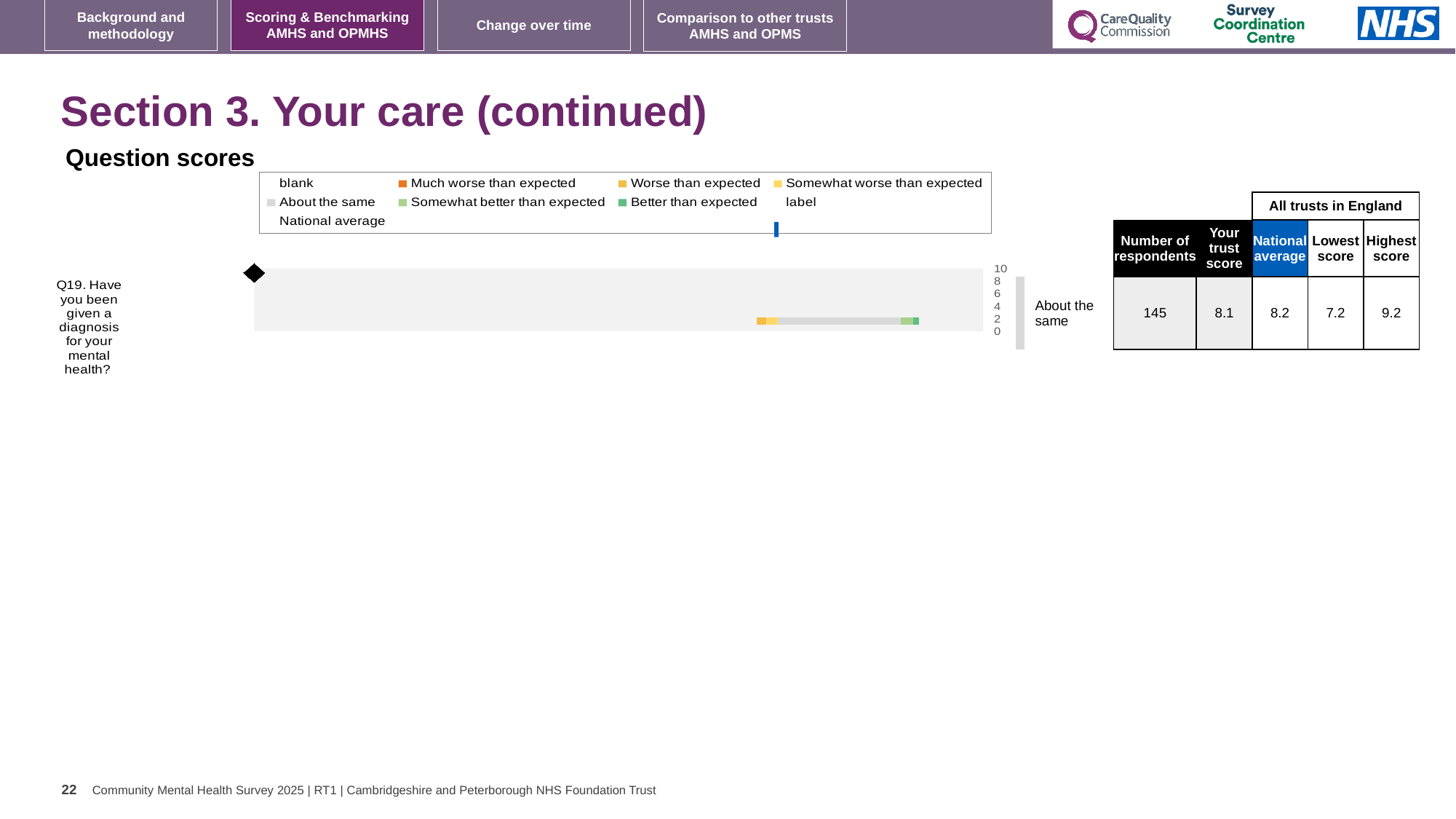
What is the lowest score among all trusts in England for Q19? 7.2 What kind of chart is used to show the question score for Q19? bar chart What is the national average score for Q19? 8.2 What is the trust's score for Q19? 8.1 Which is larger for Q19, the trust's score or the national average? national average What is the highest score among all trusts in England for Q19? 9.2 How many survey questions are plotted on the chart? 1 How many respondents answered Q19? 145 What benchmark category label is shown next to the bar for Q19? About the same Which question is plotted on the chart? Q19. Have you been given a diagnosis for your mental health? What is the difference between the highest and lowest scores for Q19 across all trusts in England? 2.0 What is the difference between the national average and the trust's score for Q19? 0.1